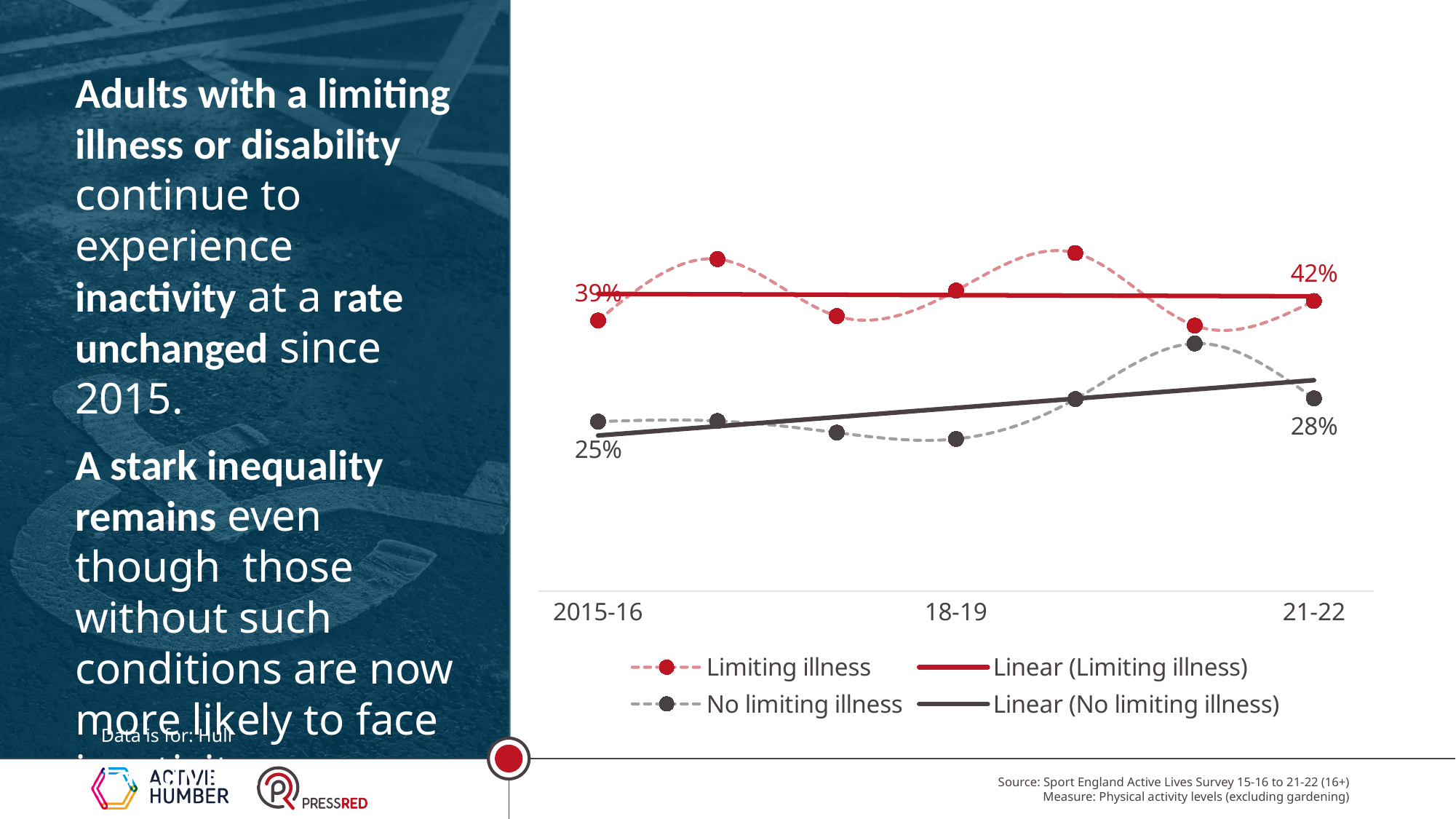
Which series has the higher value in 21-22, Limiting illness or No limiting illness? Limiting illness What is the inactivity rate for adults with no limiting illness in 21-22? 28% In 21-22, how many percentage points higher is the limiting illness rate than the no limiting illness rate? 14 percentage points In 2015-16, what is the difference between the limiting illness rate and the no limiting illness rate? 14 percentage points How many entries does the chart legend list? 4 Does the linear trendline for No limiting illness rise or fall from 2015-16 to 21-22? Rises By how many percentage points did the limiting illness rate change from 2015-16 to 21-22? 3 percentage points What is the inactivity rate for adults with no limiting illness in 2015-16? 25% What kind of chart is shown on the slide? Line chart How many data points are plotted for the Limiting illness series? 7 What is the inactivity rate for adults with a limiting illness in 21-22? 42% What is the inactivity rate for adults with a limiting illness in 2015-16? 39%